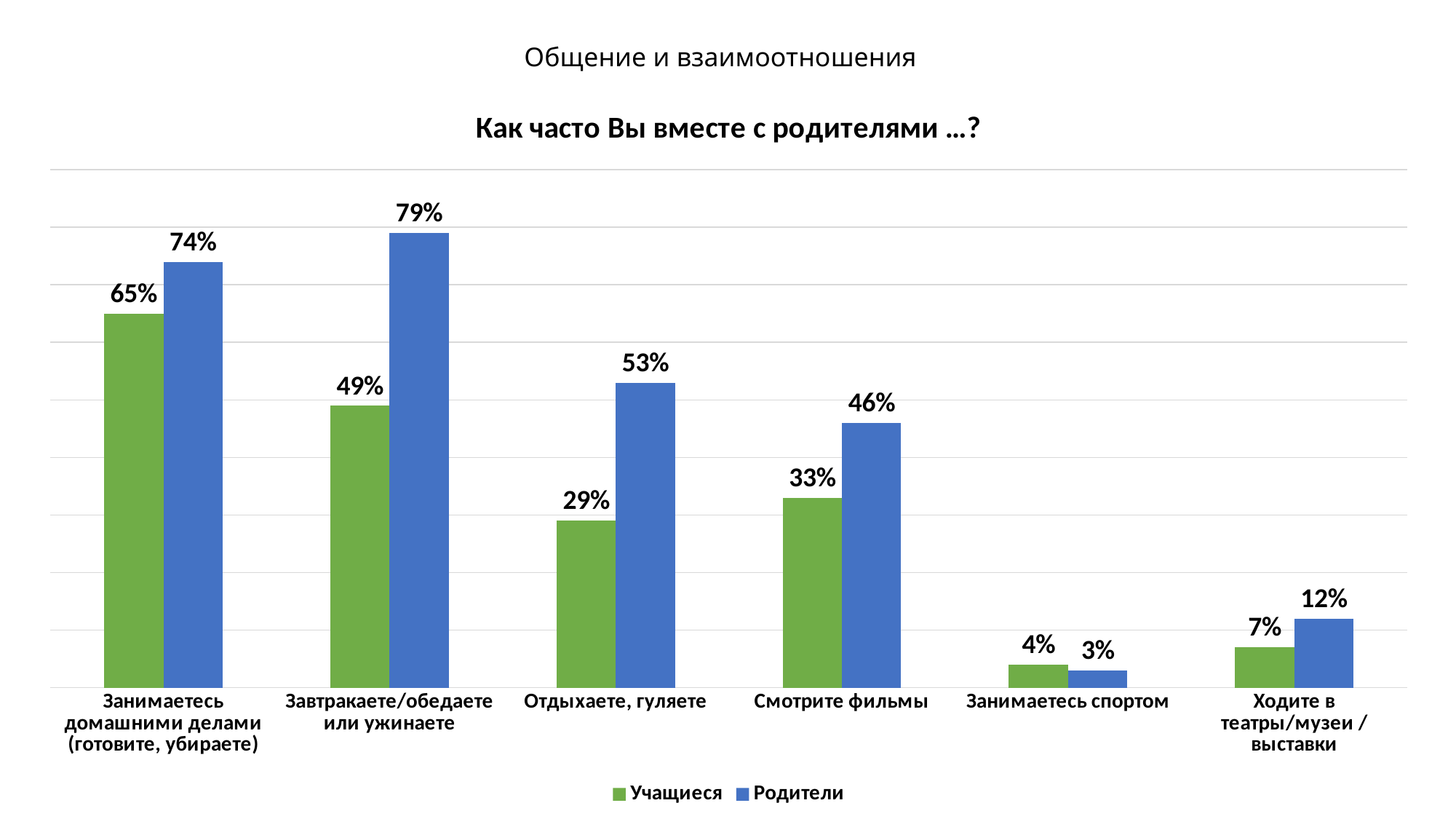
What is the value for Учащиеся in the category Отдыхаете, гуляете? 29% What is the value for Учащиеся in the category Ходите в театры/музеи / выставки? 7% How many categories are shown on the x axis? 6 How many series does the legend list? 2 What is the title of the chart? Как часто Вы вместе с родителями …? What is the difference between the Родители and Учащиеся values for Смотрите фильмы? 13% Which category has the lowest value for Родители? Занимаетесь спортом What kind of chart is shown on the slide? Bar chart Which category has the highest value for Учащиеся? Занимаетесь домашними делами (готовите, убираете) What is the difference between the Родители and Учащиеся values for Завтракаете/обедаете или ужинаете? 30% What is the value for Родители in the category Завтракаете/обедаете или ужинаете? 79% Which is larger in the category Занимаетесь спортом: the value for Учащиеся or for Родители? Учащиеся